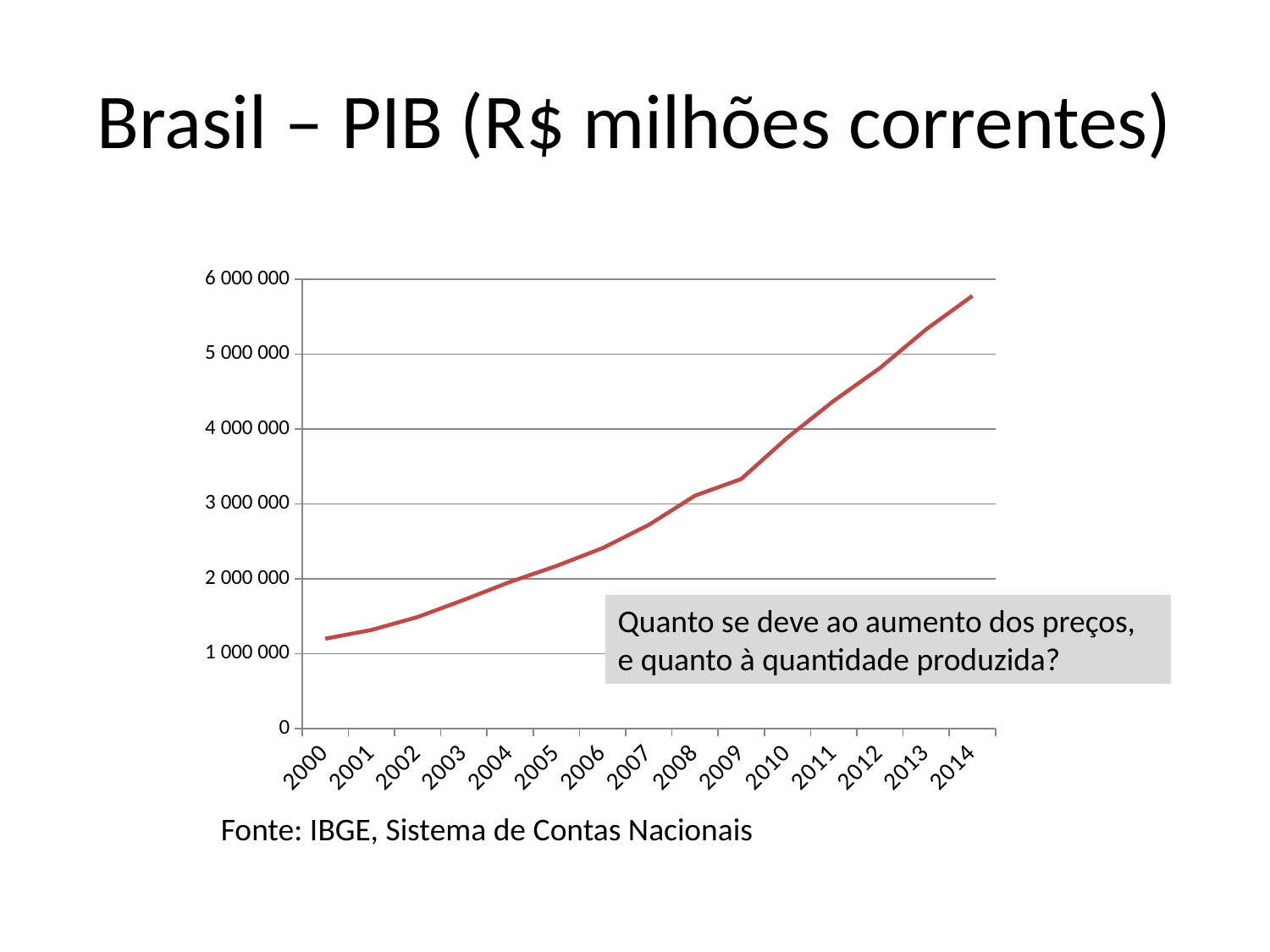
Is the value for 2000 greater or less than 1 000 000? greater Which is larger, the value for 2012 or the value for 2008? 2012 Which year has the lowest value? 2000 What is the title of the chart on the slide? Brasil – PIB (R$ milhões correntes) Do the values rise or fall from 2000 to 2014? rise How many years are plotted along the x axis? 15 Is the value for 2006 greater or less than 2 000 000? greater Which year has the highest value? 2014 Is the value for 2009 greater or less than 4 000 000? less What source is cited below the chart? IBGE, Sistema de Contas Nacionais What kind of chart is shown on the slide? line chart